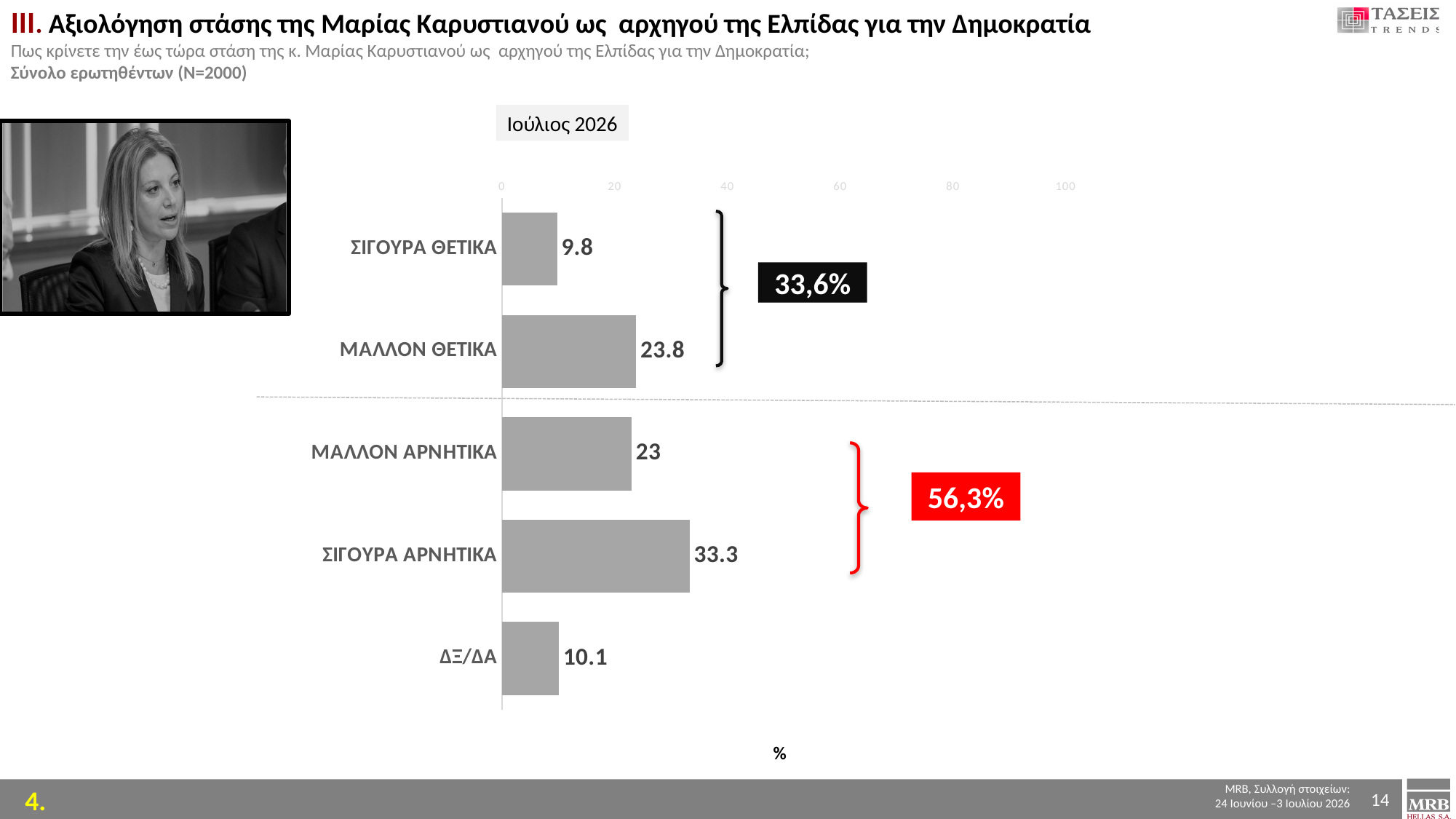
How many categories are shown in the chart? 5 What is the value for ΣΙΓΟΥΡΑ ΑΡΝΗΤΙΚΑ? 33.3 Which category has the lowest value? ΣΙΓΟΥΡΑ ΘΕΤΙΚΑ What is the value for ΜΑΛΛΟΝ ΘΕΤΙΚΑ? 23.8 What is the value for ΔΞ/ΔΑ? 10.1 Which category has the highest value? ΣΙΓΟΥΡΑ ΑΡΝΗΤΙΚΑ What is the value for ΣΙΓΟΥΡΑ ΘΕΤΙΚΑ? 9.8 What kind of chart is shown on the slide? bar chart Which is larger, the value for ΜΑΛΛΟΝ ΘΕΤΙΚΑ or the value for ΜΑΛΛΟΝ ΑΡΝΗΤΙΚΑ? ΜΑΛΛΟΝ ΘΕΤΙΚΑ What combined percentage is shown in the red box for the negative categories? 56,3% What is the difference between the values for ΣΙΓΟΥΡΑ ΑΡΝΗΤΙΚΑ and ΜΑΛΛΟΝ ΑΡΝΗΤΙΚΑ? 10.3 Is the value for ΣΙΓΟΥΡΑ ΑΡΝΗΤΙΚΑ greater or less than 40? less